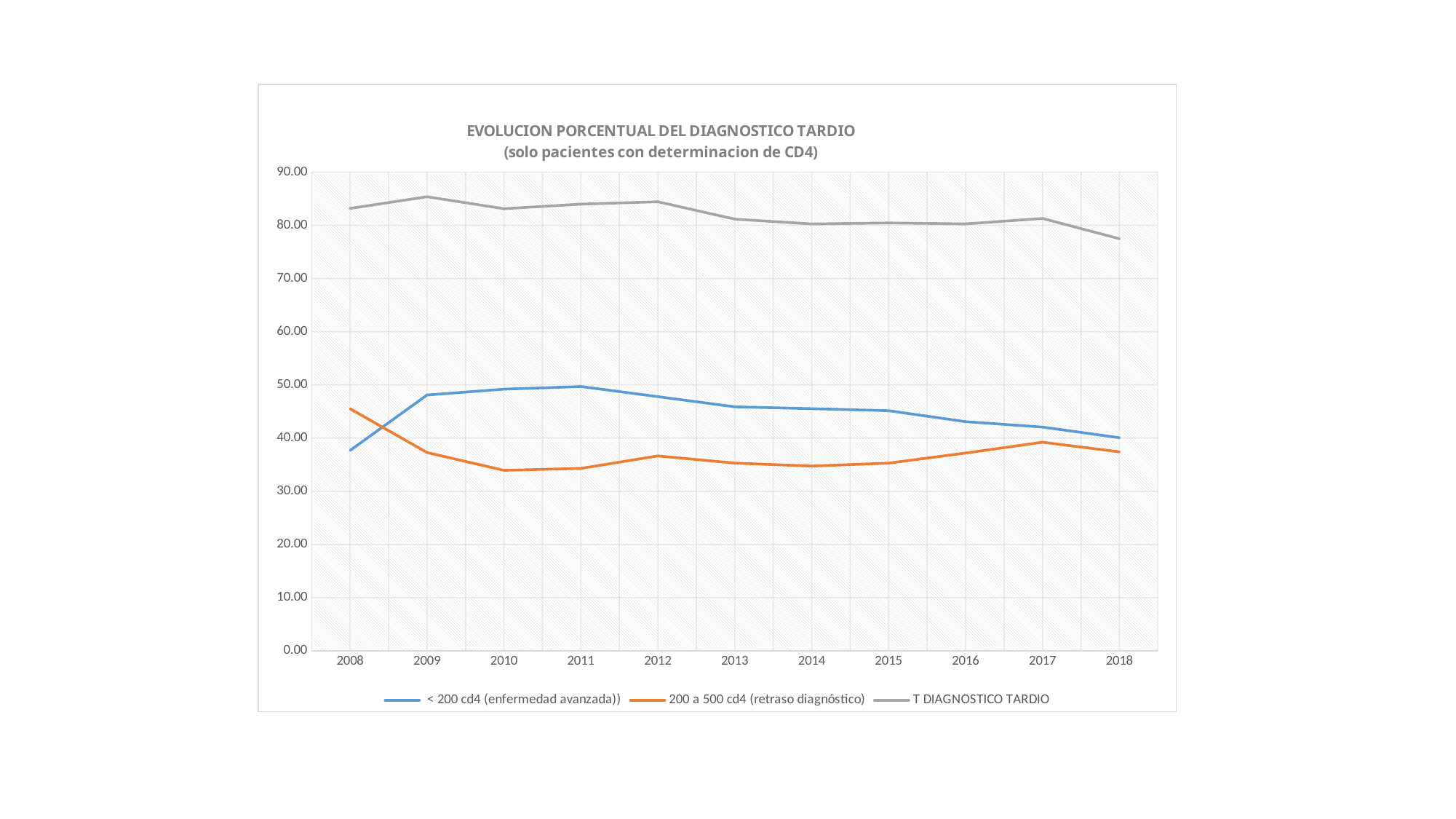
In 2008, which series has the higher value: < 200 cd4 (enfermedad avanzada) or 200 a 500 cd4 (retraso diagnóstico)? 200 a 500 cd4 (retraso diagnóstico) In 2018, which series has the higher value: < 200 cd4 (enfermedad avanzada) or 200 a 500 cd4 (retraso diagnóstico)? < 200 cd4 (enfermedad avanzada) What kind of chart is shown on the slide? line chart How many series does the legend list? 3 In which year is the T DIAGNOSTICO TARDIO series at its lowest? 2018 Does the T DIAGNOSTICO TARDIO series overall rise or fall from 2008 to 2018? fall Is the value for < 200 cd4 (enfermedad avanzada) in 2011 greater or less than 40.00? greater In which year is the 200 a 500 cd4 (retraso diagnóstico) series at its highest? 2008 Is the value for T DIAGNOSTICO TARDIO in 2018 greater or less than 80.00? less How many years are shown on the x axis? 11 Is the value for T DIAGNOSTICO TARDIO in 2009 greater or less than 80.00? greater